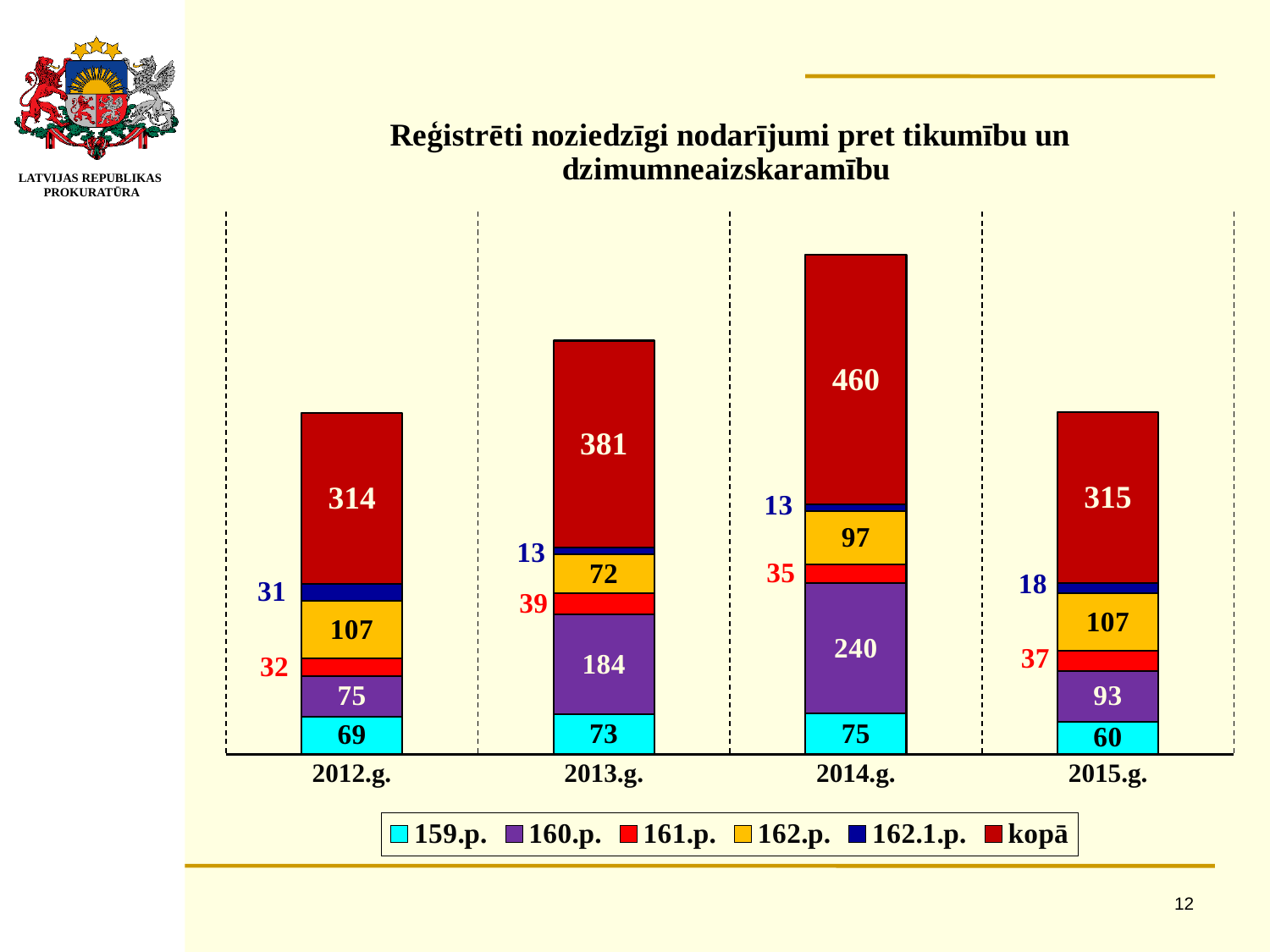
What is the value for 160.p. in 2014.g.? 240 What is the difference between the kopā values for 2013.g. and 2012.g.? 67 Which is larger, the value for 160.p. in 2013.g. or in 2015.g.? 2013.g. What colour represents the 162.1.p. series in the legend? dark blue What is the value for 162.p. in 2013.g.? 72 In which year is the value for 159.p. lowest? 2015.g. How many years are shown on the x axis? 4 What is the value for 161.p. in 2012.g.? 32 In which year is the kopā value highest? 2014.g. What is the kopā value for 2015.g.? 315 What kind of chart is shown on the slide? stacked bar chart How many series does the legend list? 6